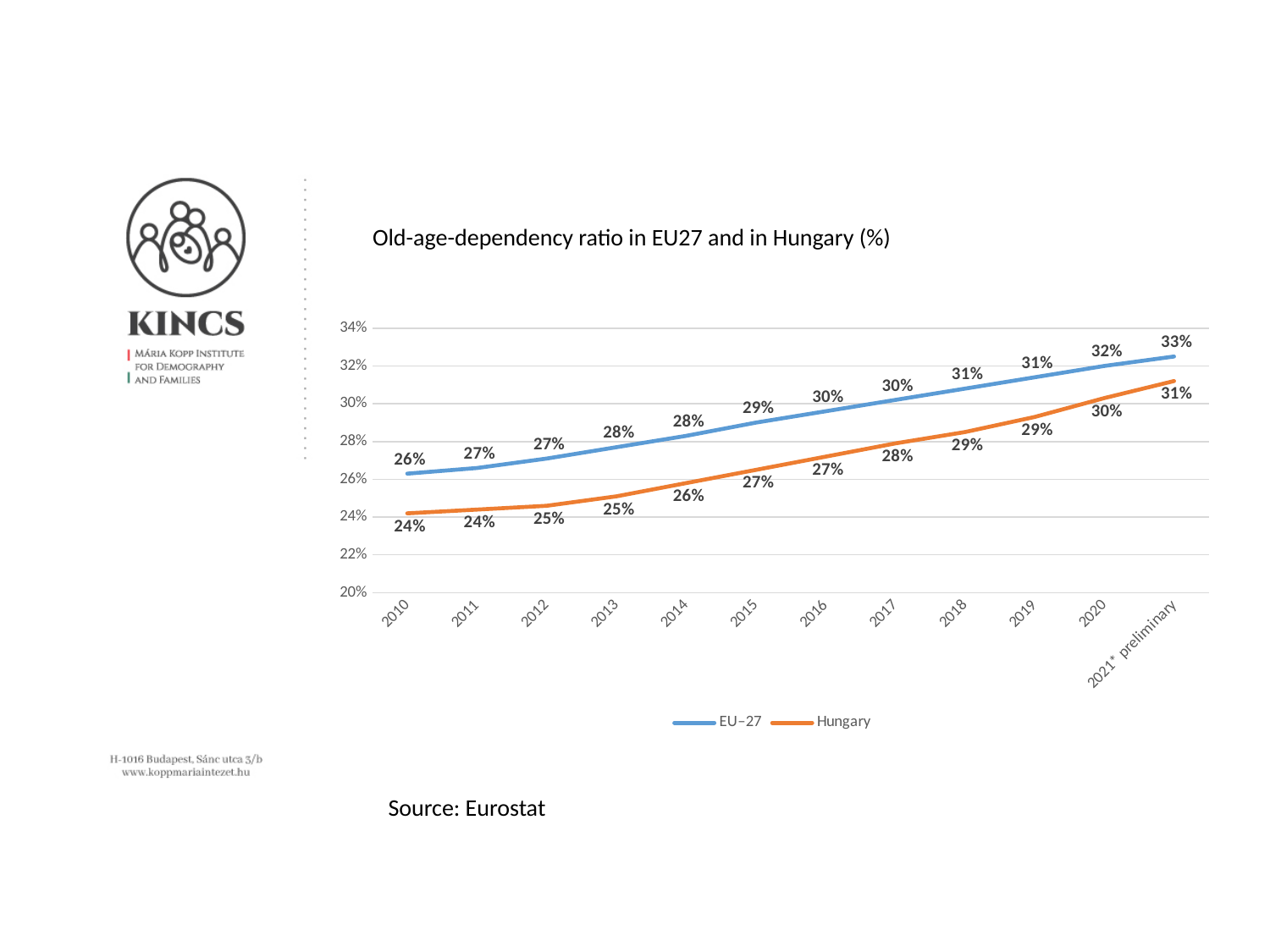
What is the difference between the EU-27 and Hungary values in 2010? 2% What is the Hungary old-age-dependency ratio in 2021* preliminary? 31% What is the EU-27 value for 2016? 30% What is the lowest value shown for Hungary? 24% What is the Hungary value for 2014? 26% In which year is the EU-27 value highest? 2021* preliminary Which series has the larger value in 2018, EU-27 or Hungary? EU-27 How many series does the legend list? 2 How many years are shown on the x axis? 12 Do the Hungary values rise or fall from 2010 to 2021* preliminary? Rise What kind of chart is shown on the slide? Line chart What is the EU-27 old-age-dependency ratio in 2010? 26%